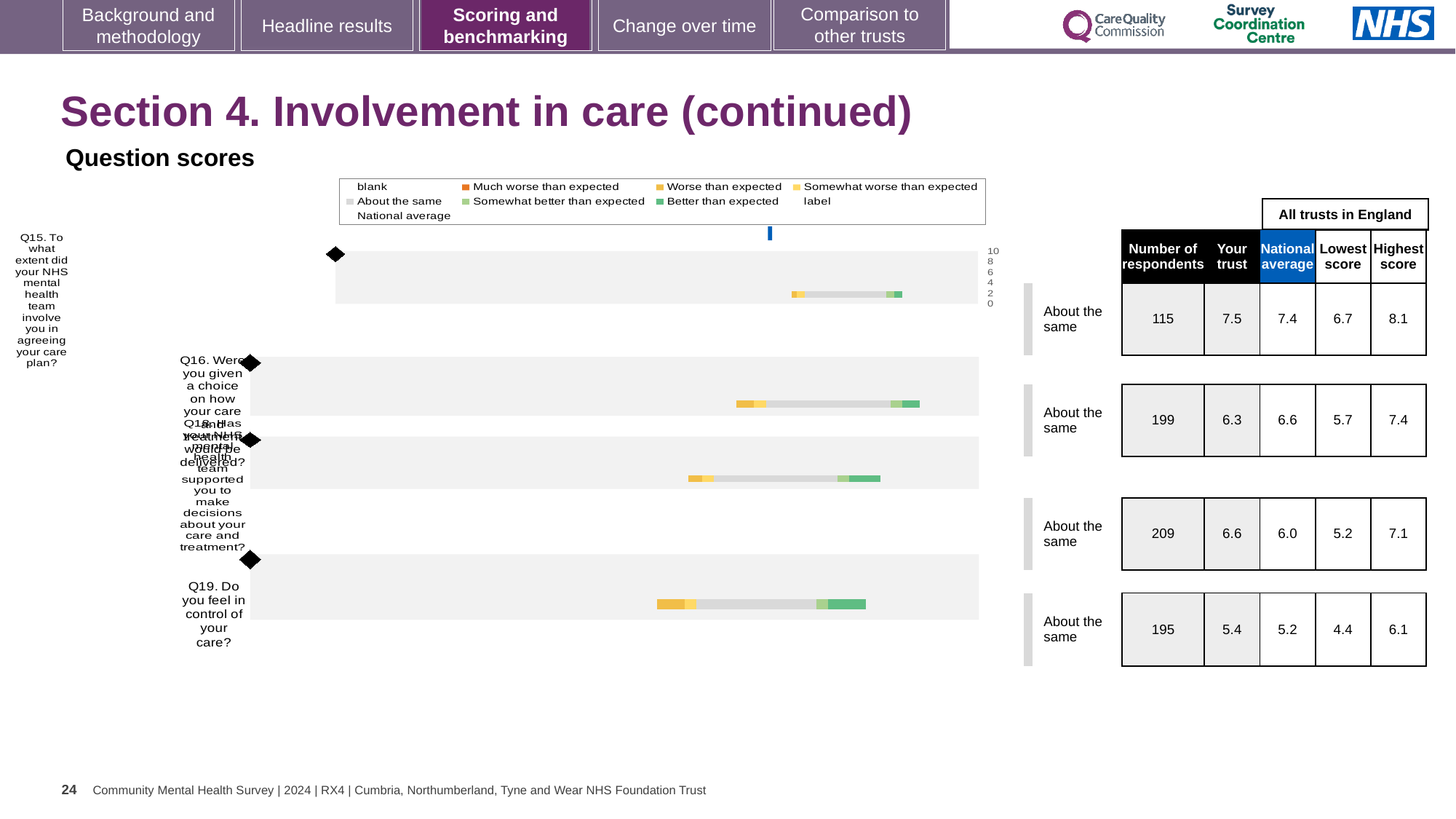
Which question has the largest number of respondents? Q18 What type of chart is used to show the question scores? Bar chart What is the 'Your trust' score for Q16 (choice on how care and treatment would be delivered)? 6.3 Which question has the highest 'Your trust' score? Q15 What is the lowest score among all trusts in England for Q15? 6.7 How many questions are plotted in the question scores chart? 4 What is the national average score for Q19 (feeling in control of your care)? 5.2 What is the difference between the 'Your trust' score and the national average for Q18? 0.6 What is the highest score among all trusts in England for Q18 (supported to make decisions about care and treatment)? 7.1 Which question has the lowest 'Your trust' score? Q19 How many respondents answered Q15 (involvement in agreeing your care plan)? 115 For Q16, which is larger: the 'Your trust' score or the national average? National average